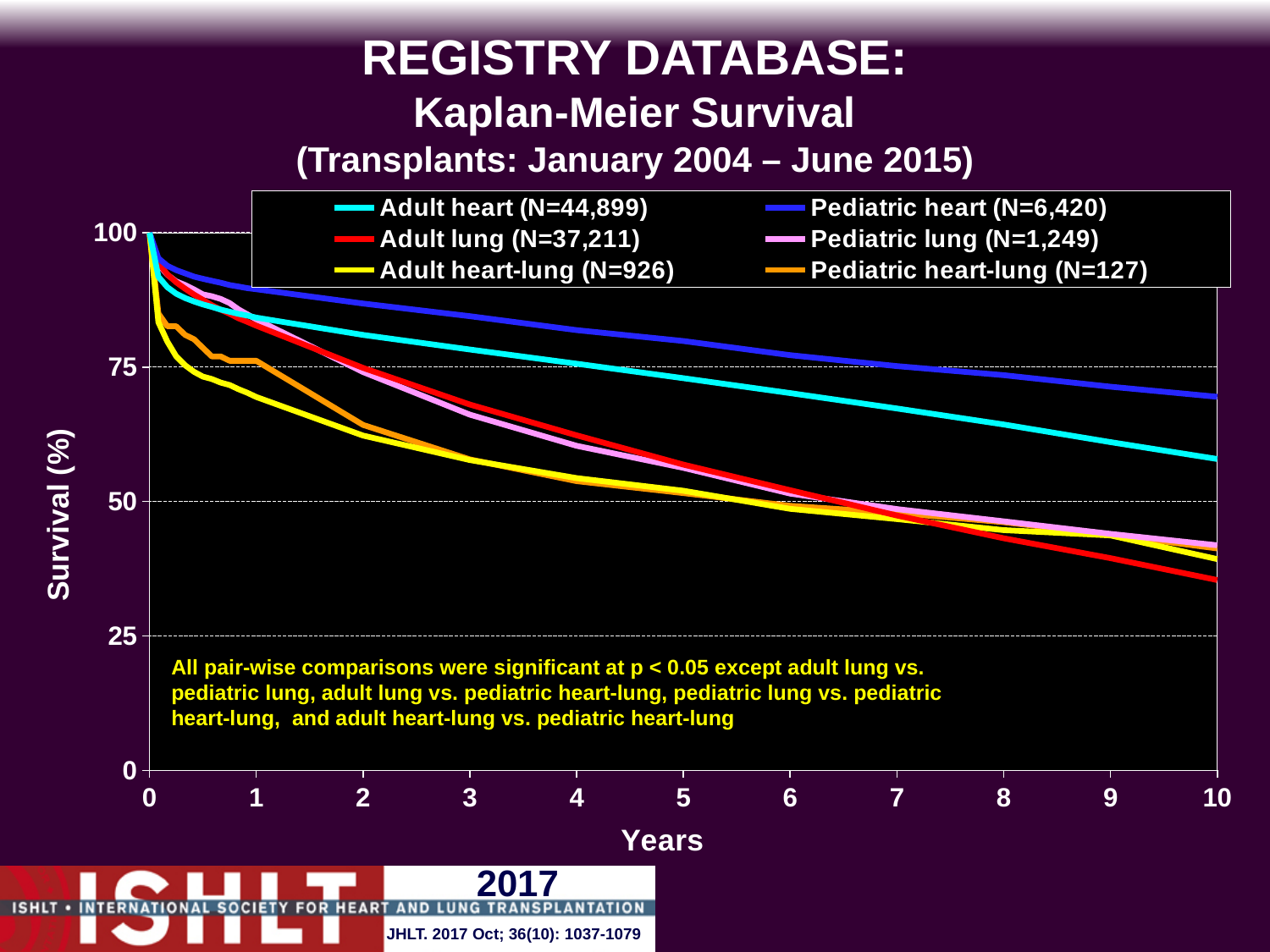
What kind of chart is shown on the slide? line chart Which series has the lowest survival at 10 years? Adult lung Do the survival curves rise or fall as years increase? fall Is the survival for Pediatric heart at 10 years greater or less than 50? greater Which series has the highest survival at 10 years? Pediatric heart What is the N shown in the legend for Adult heart? 44,899 Is the survival for Pediatric heart at 5 years greater or less than 75? greater How many series does the legend list? 6 Is the survival for Adult heart-lung at 1 year greater or less than 75? less At 10 years, which is higher: Adult heart or Pediatric heart survival? Pediatric heart What colour is the Pediatric heart line? blue